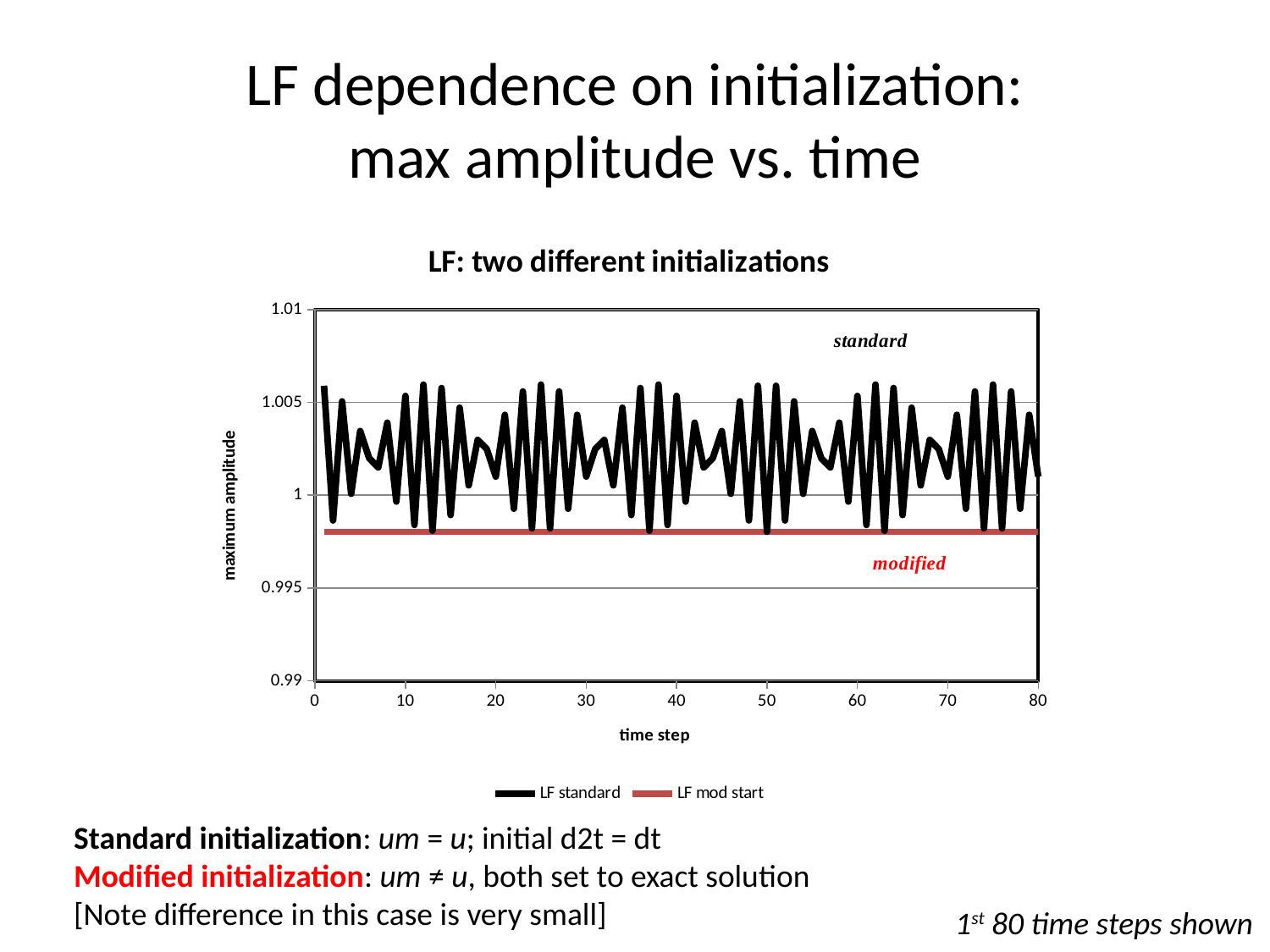
How many series does the legend list? 2 Is the lowest value reached by the LF standard series greater or less than 0.995? greater Which series has the larger values across the time steps, LF standard or LF mod start? LF standard Which series oscillates up and down across the time steps? LF standard What is the label of the x axis? time step Is the highest value reached by the LF standard series greater or less than 1.01? less What kind of chart is shown on the slide? line chart Does the LF mod start series rise, fall, or stay flat as the time step increases? stay flat What is the title of the chart? LF: two different initializations Is the value of the LF mod start series greater or less than 0.995? greater What is the largest time step shown on the x axis? 80